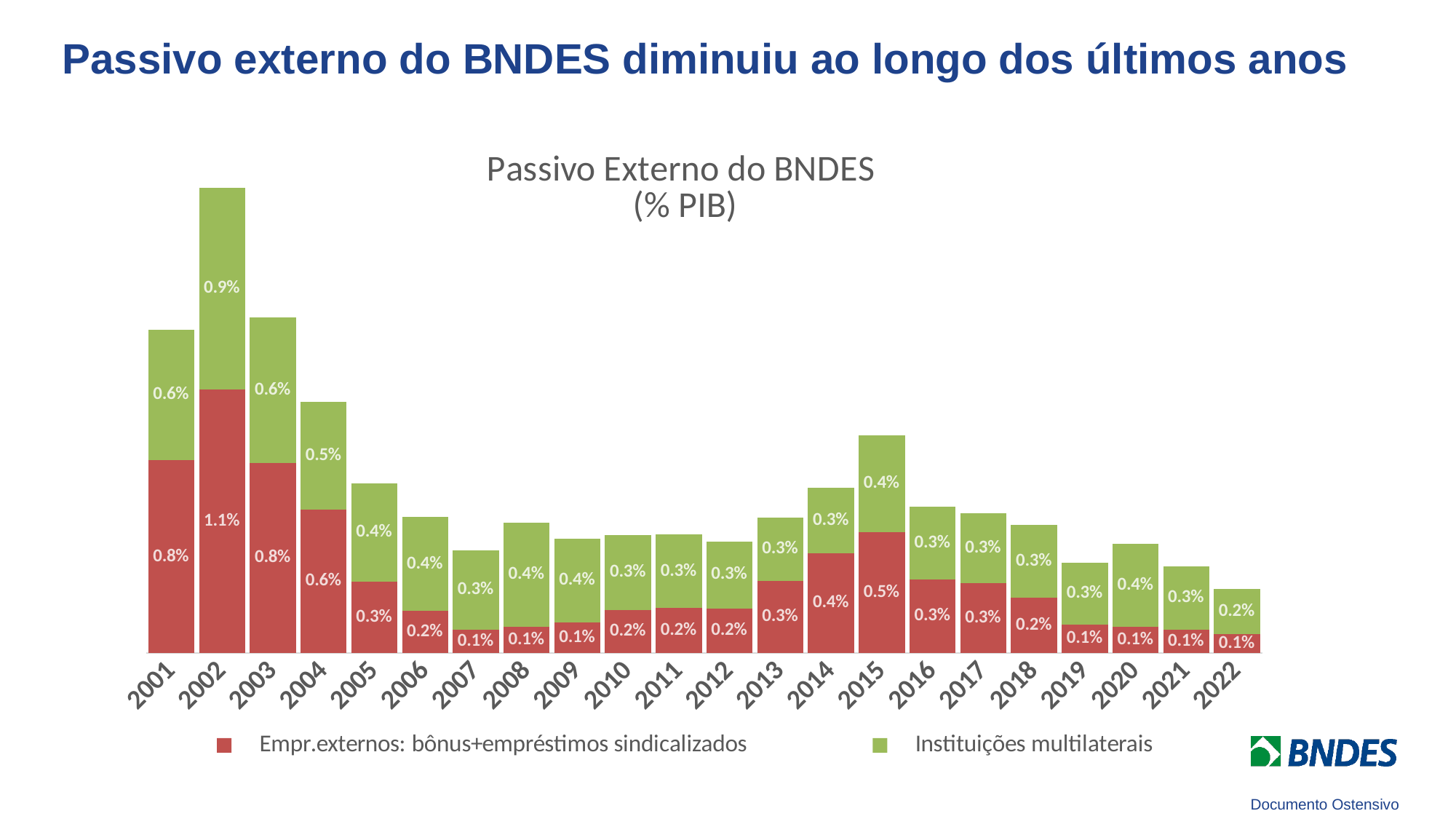
What is the total of the stacked bar for 2022? 0.3% What is the difference between the Instituições multilaterais values for 2002 and 2022? 0.7% How many years are shown on the x axis? 22 In which year is the total stacked bar the lowest? 2022 What is the value for Empr.externos: bônus+empréstimos sindicalizados in 2022? 0.1% In which year is the Empr.externos: bônus+empréstimos sindicalizados value highest? 2002 What is the total of the stacked bar for 2002? 2.0% What is the value for Empr.externos: bônus+empréstimos sindicalizados in 2002? 1.1% What kind of chart is shown on the slide? Stacked bar chart Which is larger in 2014: Empr.externos: bônus+empréstimos sindicalizados or Instituições multilaterais? Empr.externos: bônus+empréstimos sindicalizados How many series does the legend list? 2 What is the value for Instituições multilaterais in 2015? 0.4%